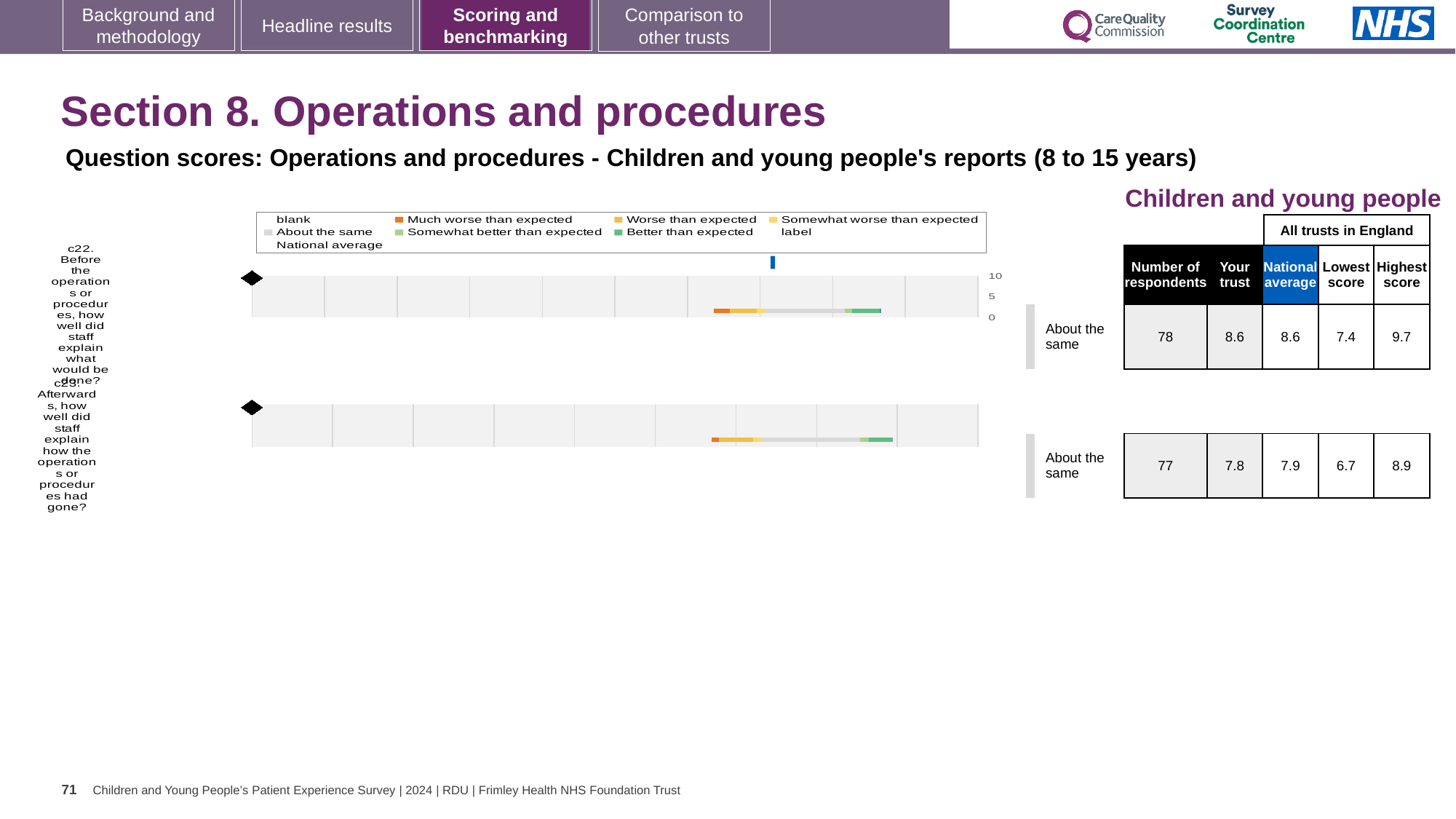
What is the 'Your trust' score for question c22 (Before the operations or procedures, how well did staff explain what would be done?)? 8.6 How many respondents answered question c22? 78 What kind of chart is used to show the question scores on this slide? bar chart What colour does the chart legend use for 'Better than expected'? green What is the highest value shown on the chart's axis? 10 What is the national average score for question c23? 7.9 What colour does the chart legend use for 'Much worse than expected'? orange What is the highest score among all trusts in England for question c22? 9.7 How many questions (categories) are plotted in the chart on this slide? 2 For question c23, which is larger: the trust's score or the national average? national average What is the 'Your trust' score for question c23 (Afterwards, how well did staff explain how the operations or procedures had gone?)? 7.8 What is the difference between the highest score and the lowest score for question c22? 2.3